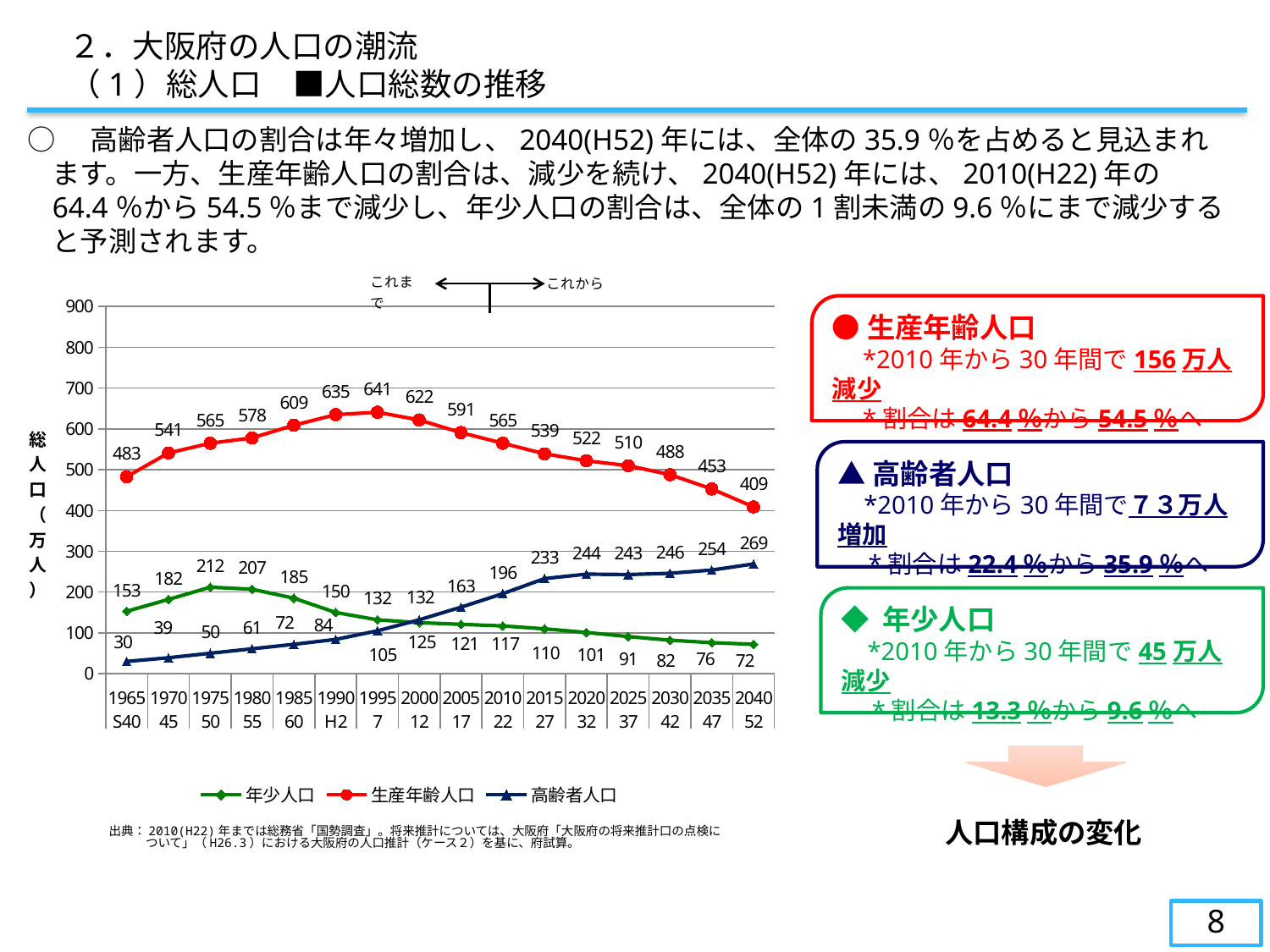
How many series does the legend list? 3 What is the value of 生産年齢人口 in 1995? 641 In which year does 生産年齢人口 reach its highest value? 1995 What colour is the line for 生産年齢人口? red What kind of chart is shown on the slide? line chart How many years (data points) are plotted along the x axis? 16 What is the value of 年少人口 in 1975? 212 What is the difference between 生産年齢人口 in 2010 and in 2040? 156 Does 高齢者人口 generally rise or fall from 1965 to 2040? rise Which is larger in 2040, 高齢者人口 or 年少人口? 高齢者人口 In which year is 高齢者人口 at its lowest value? 1965 What is the value of 高齢者人口 in 2040? 269